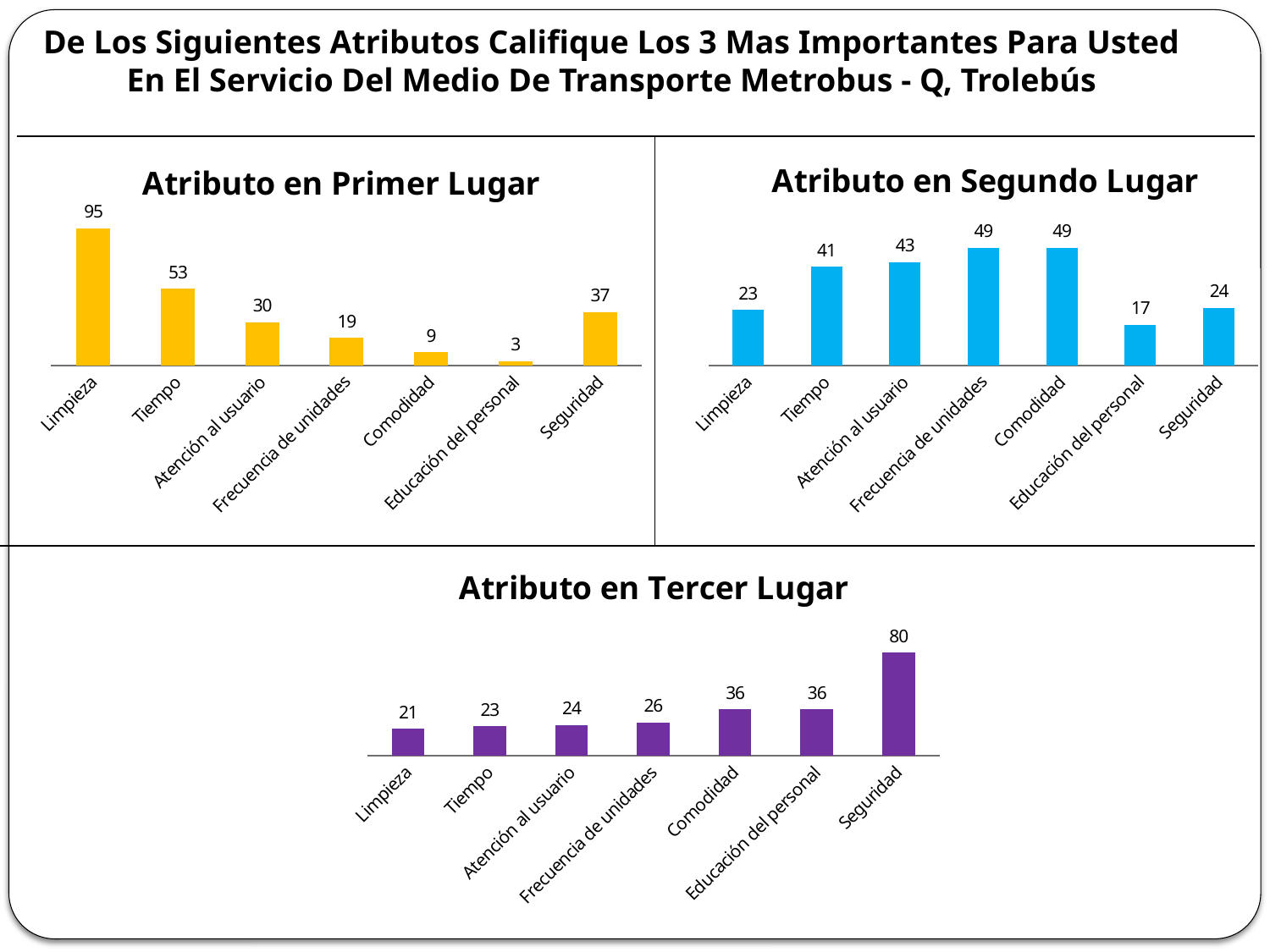
In the 'Atributo en Primer Lugar' chart, what is the value for Limpieza? 95 In the 'Atributo en Segundo Lugar' chart, which is larger, Tiempo or Seguridad? Tiempo What type of chart is 'Atributo en Primer Lugar'? Bar chart In the 'Atributo en Primer Lugar' chart, which category has the lowest value? Educación del personal In the 'Atributo en Tercer Lugar' chart, which category has the highest value? Seguridad In the 'Atributo en Tercer Lugar' chart, what is the value for Seguridad? 80 What colour are the bars in the 'Atributo en Segundo Lugar' chart? Blue In the 'Atributo en Segundo Lugar' chart, which category has the lowest value? Educación del personal In the 'Atributo en Segundo Lugar' chart, what is the value for Atención al usuario? 43 In the 'Atributo en Tercer Lugar' chart, what is the difference between Seguridad and Comodidad? 44 In the 'Atributo en Primer Lugar' chart, what is the difference between Limpieza and Tiempo? 42 How many categories are shown in the 'Atributo en Tercer Lugar' chart? 7